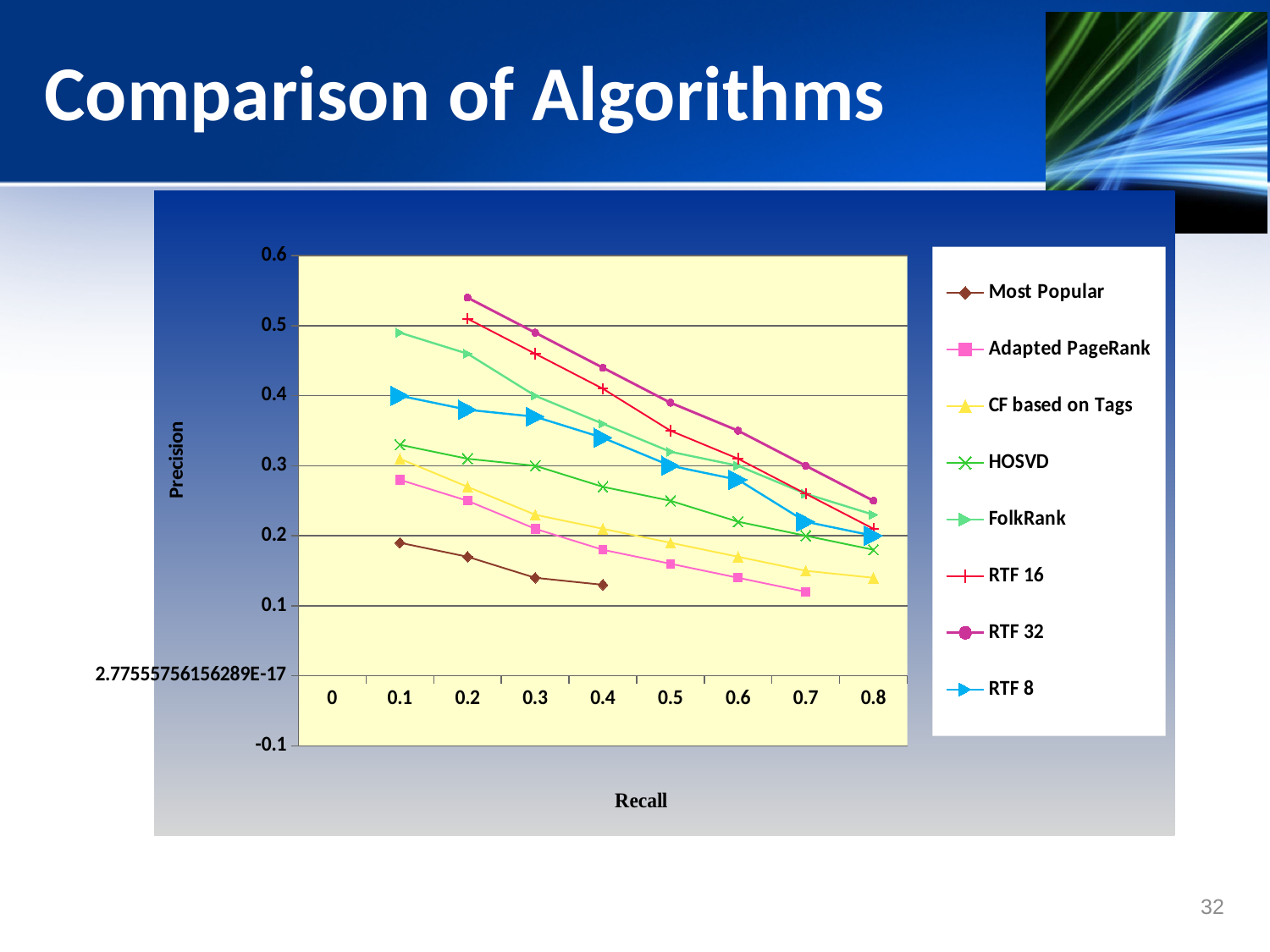
Which series has the lowest precision at recall 0.1? Most Popular Is the precision of Adapted PageRank at recall 0.7 greater or less than 0.2? less Do the precision values rise or fall as recall increases along the x axis? fall How many series does the legend list? 8 Is the precision of RTF 32 at recall 0.2 greater or less than 0.5? greater What kind of chart is shown on the slide? line chart What is the label of the y axis? Precision Which series has the highest precision at recall 0.2? RTF 32 How many data points are plotted for the Most Popular series? 4 At recall 0.5, which series has the higher precision, FolkRank or HOSVD? FolkRank What is the label of the x axis? Recall Is the precision of Most Popular at recall 0.4 greater or less than 0.2? less